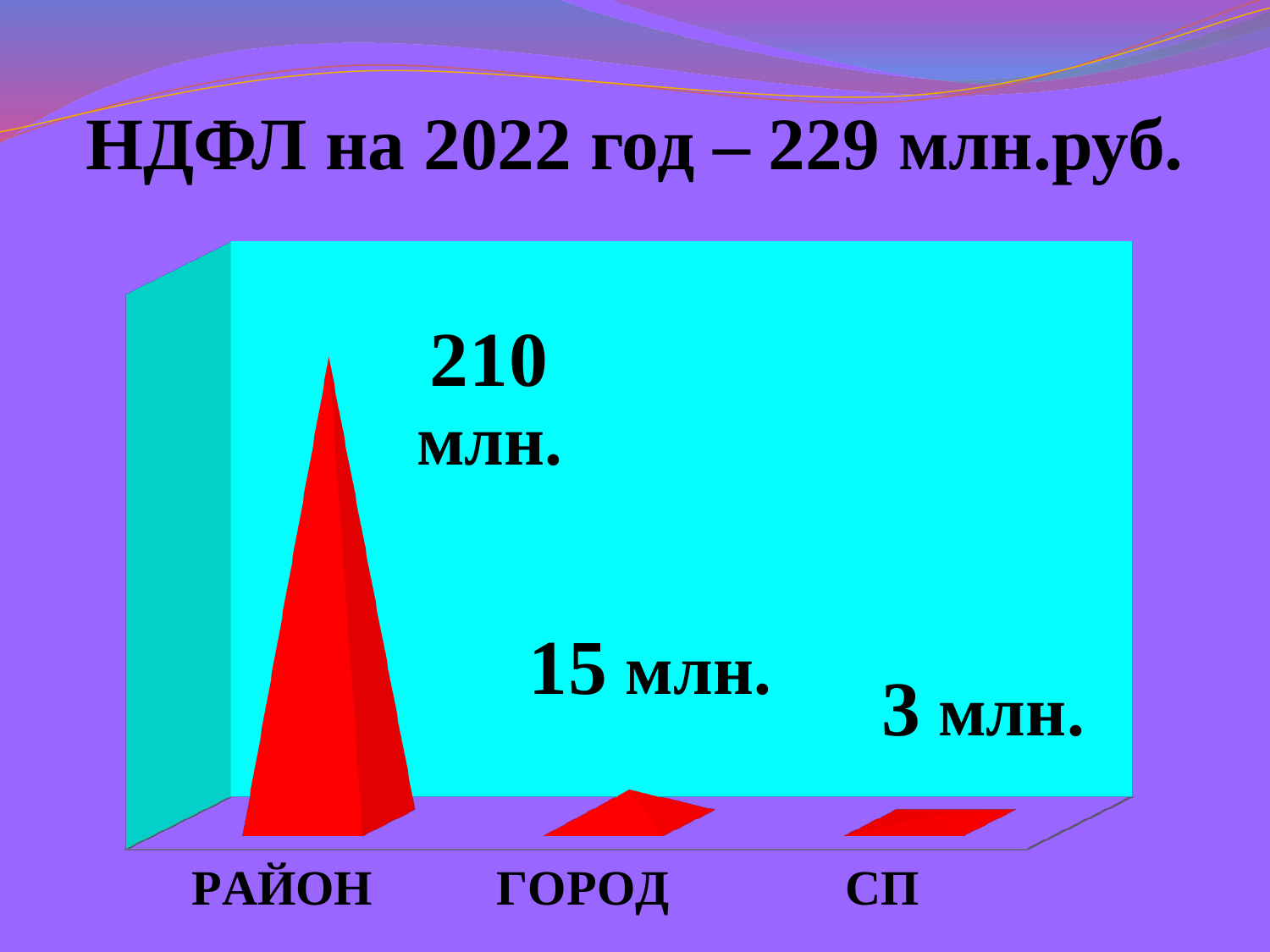
Which category has the lowest value? СП Do the values rise or fall from left to right across the categories? fall How many categories are shown on the chart? 3 What is the title of the slide? НДФЛ на 2022 год – 229 млн.руб. Which category has the highest value? РАЙОН What is the difference between the values for РАЙОН and ГОРОД? 195 млн. What is the value for РАЙОН? 210 млн. What is the difference between the values for ГОРОД and СП? 12 млн. What is the value for ГОРОД? 15 млн. What kind of chart is shown on the slide? bar chart Which is larger, the value for ГОРОД or the value for СП? ГОРОД What is the value for СП? 3 млн.